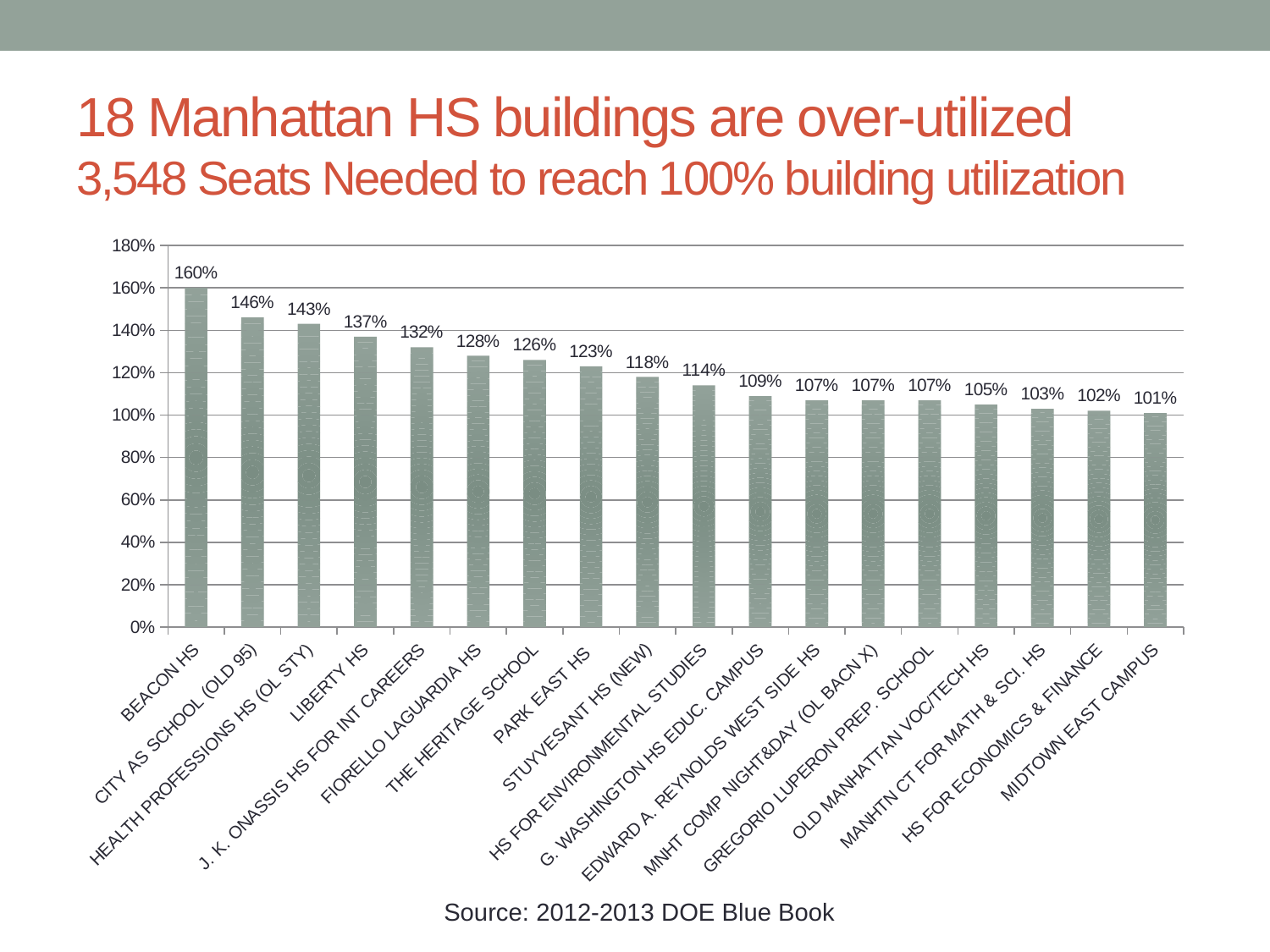
Which has a higher utilization, PARK EAST HS or THE HERITAGE SCHOOL? THE HERITAGE SCHOOL What is the utilization value for LIBERTY HS? 137% What kind of chart is shown on the slide? Bar chart How many school buildings are shown in the chart? 18 What source is cited below the chart? 2012-2013 DOE Blue Book Do the values rise or fall from left to right along the x axis? Fall What is the utilization value for STUYVESANT HS (NEW)? 118% What is the difference between the utilization of BEACON HS and CITY AS SCHOOL (OLD 95)? 14% Which school building has the lowest utilization? MIDTOWN EAST CAMPUS What is the utilization value for MIDTOWN EAST CAMPUS? 101% What is the utilization value for BEACON HS? 160% Which school building has the highest utilization? BEACON HS